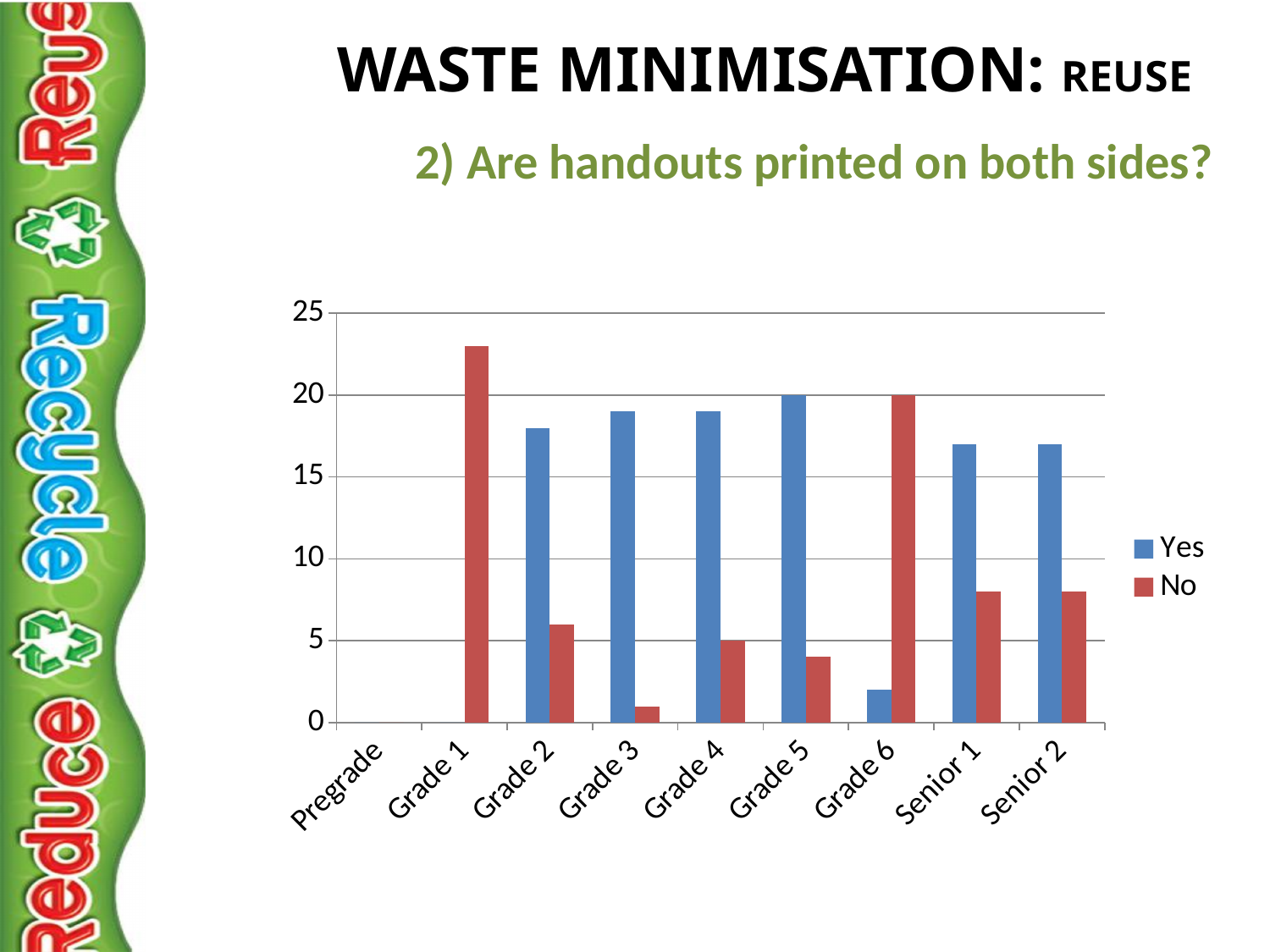
Is the value of the No bar for Grade 1 greater or less than 20? greater For Grade 6, which is larger, the Yes bar or the No bar? No What kind of chart is shown on the slide? bar chart Is the value of the Yes bar for Senior 1 greater or less than 15? greater What is the value of the Yes bar for Grade 5? 20 Which category has the highest No bar? Grade 1 What is the value of the No bar for Grade 4? 5 How many categories are shown along the x axis? 9 Which colour represents the Yes series in the legend? blue What is the value of the No bar for Grade 6? 20 Is the value of the Yes bar for Grade 6 greater or less than 5? less How many series does the legend list? 2